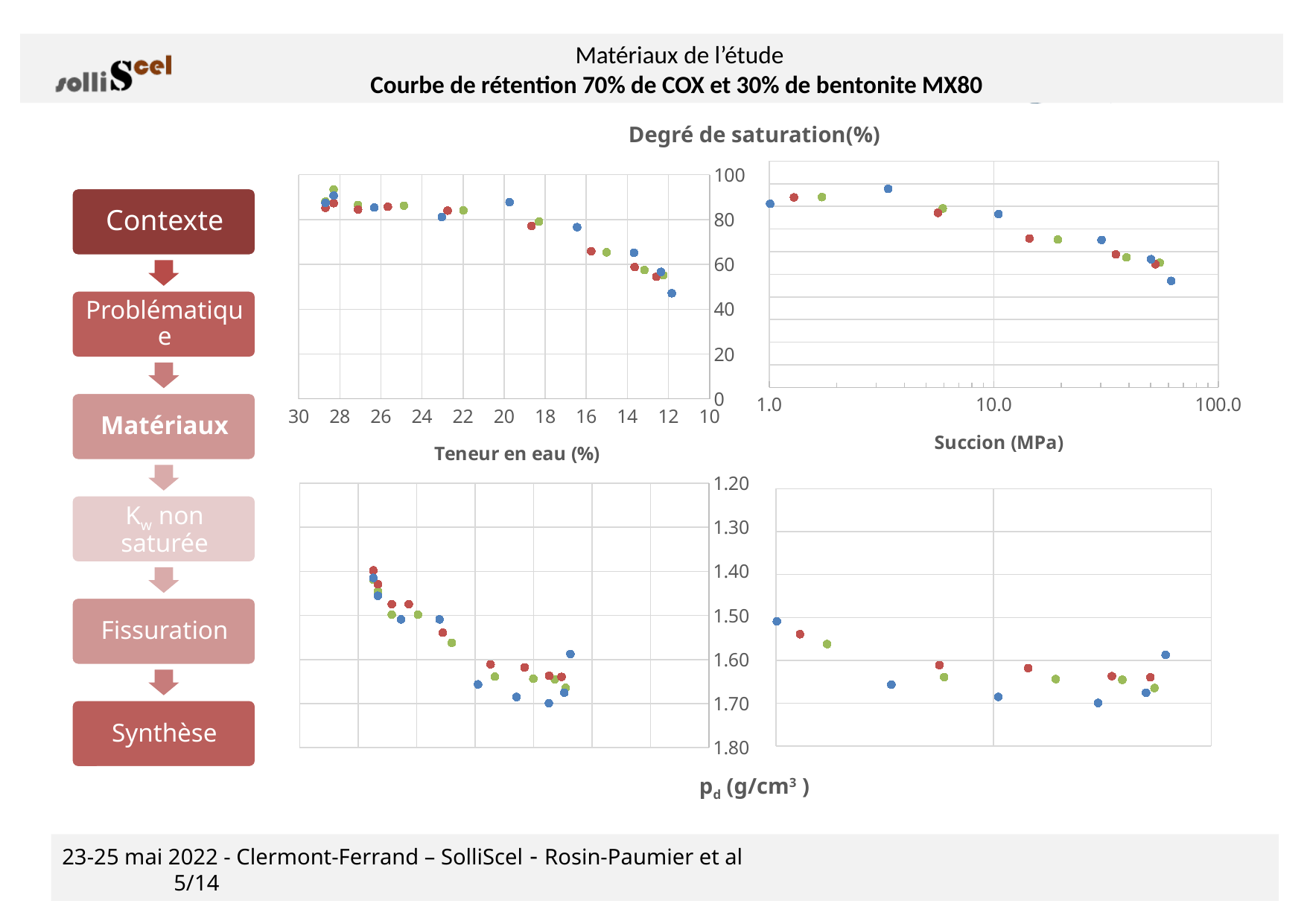
How many charts are shown on the slide? 4 What is the x-axis title of the top-right chart? Succion (MPa) In the top-right chart, is the blue point at a suction of 1.0 MPa greater or less than 80? greater In the top-right chart, is the lowest blue point (near 60 MPa) greater or less than 60? less In the top-left chart, do the 'Degré de saturation' values rise or fall moving from left to right along the x axis? fall What kind of chart is the top-left chart with the x axis 'Teneur en eau (%)'? scatter chart In the top-left chart, is the blue point at a water content of 20% greater or less than 80? greater What is the x-axis title of the top-left chart? Teneur en eau (%) In the top-right chart with the x axis 'Succion (MPa)', do the saturation values rise or fall as suction increases? fall